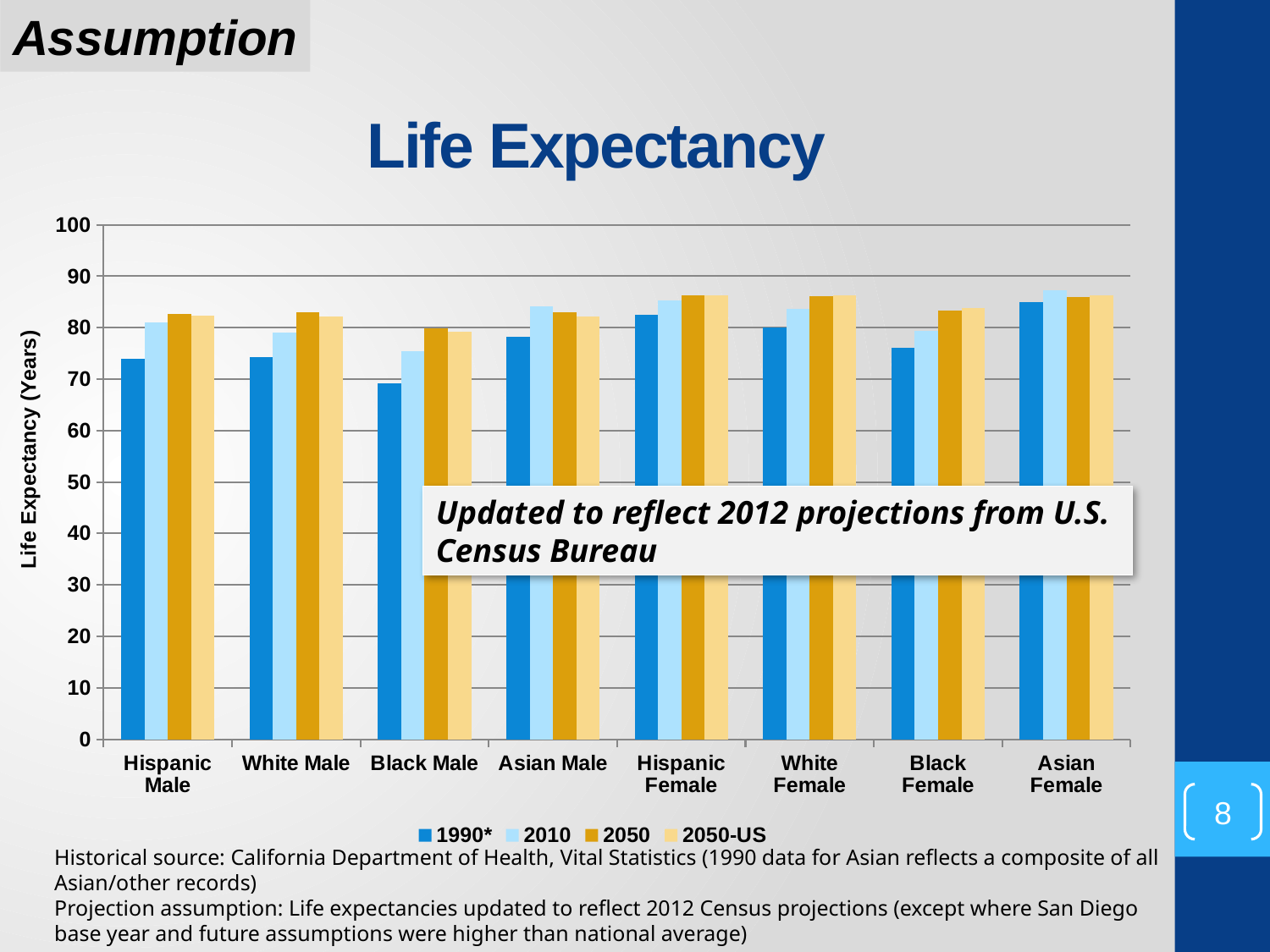
Is the 1990* value for Asian Female greater or less than 80? greater Which category has the lowest value for the 2010 series? Black Male Which is larger for the 1990* series: the value for White Male or the value for Black Male? White Male What is the title of the chart's vertical axis? Life Expectancy (Years) For Black Male, do the values rise or fall from the 1990* series to the 2050 series? rise Which category has the highest value for the 1990* series? Asian Female Is the 2010 value for Black Male greater or less than 80? less Which category has the lowest value for the 1990* series? Black Male What type of chart is shown on the slide? bar chart How many series does the chart's legend list? 4 How many categories are shown on the x axis of the chart? 8